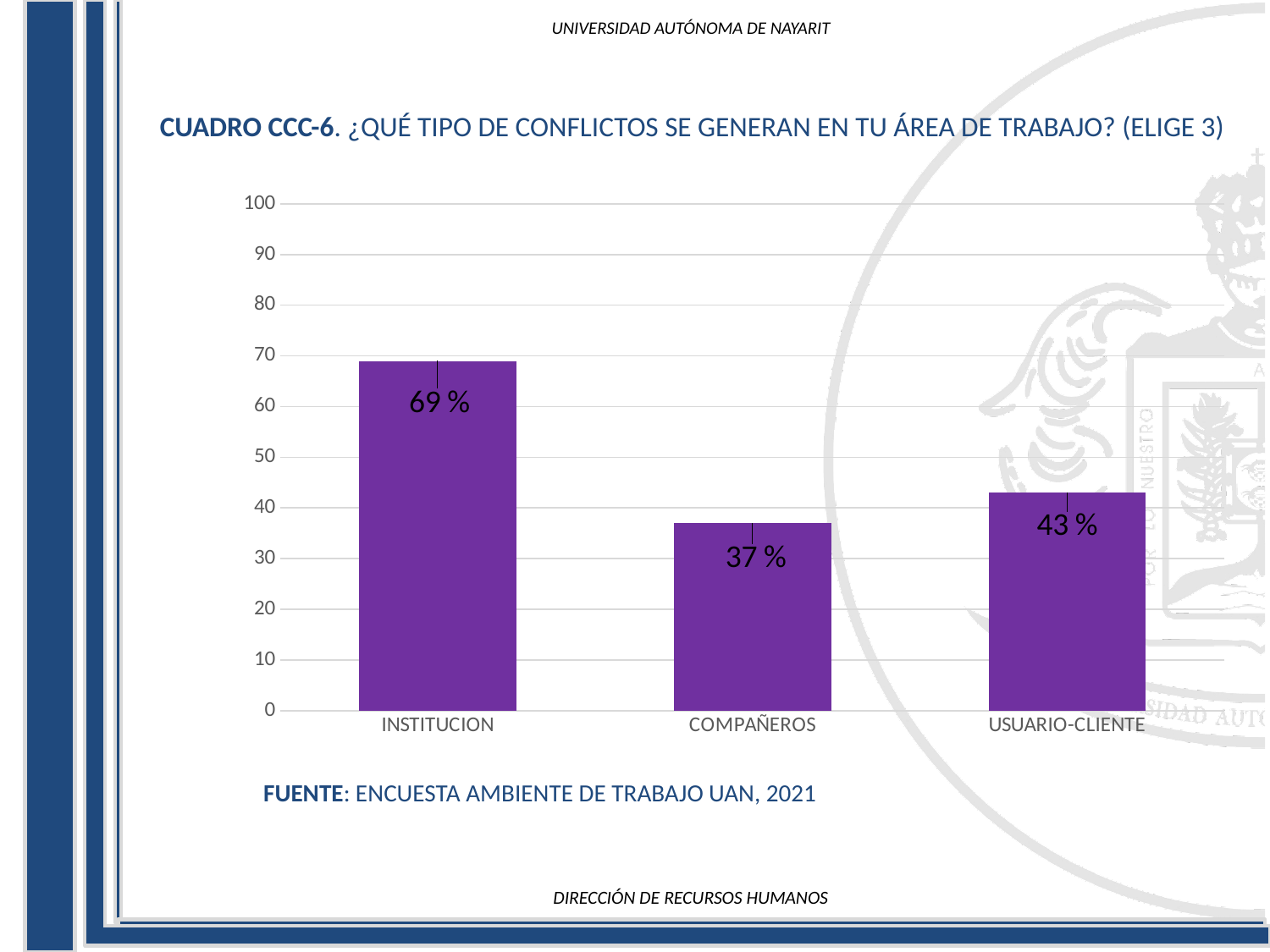
What kind of chart is shown on the slide? Bar chart How many categories are shown on the x axis? 3 What is the value for INSTITUCION? 69 % What is the value for USUARIO-CLIENTE? 43 % Which category has the highest value? INSTITUCION What is the difference between the values for INSTITUCION and COMPAÑEROS? 32 % What is the difference between the values for USUARIO-CLIENTE and COMPAÑEROS? 6 % What is the value for COMPAÑEROS? 37 % Is the value for INSTITUCION greater or less than 60? greater Which is larger, the value for USUARIO-CLIENTE or the value for COMPAÑEROS? USUARIO-CLIENTE Which category has the lowest value? COMPAÑEROS What source is cited below the chart? ENCUESTA AMBIENTE DE TRABAJO UAN, 2021